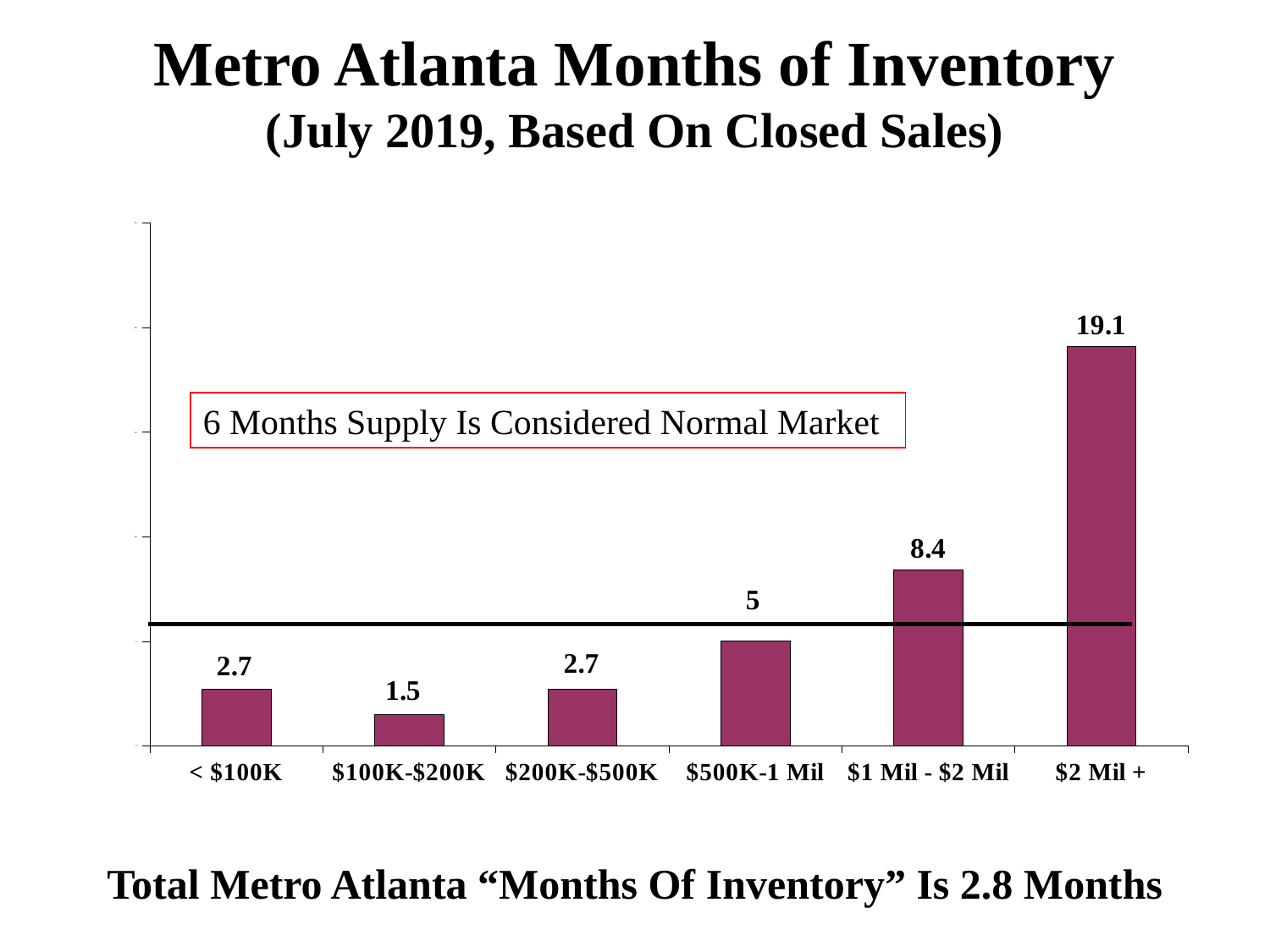
Which price range has the highest months of inventory? $2 Mil + According to the text box on the chart, how many months of supply is considered a normal market? 6 months What is the months of inventory value for the $500K-1 Mil price range? 5 What is the months of inventory value for the $2 Mil + price range? 19.1 Which price range has the lowest months of inventory? $100K-$200K What kind of chart is shown on the slide? Bar chart How many price range categories are shown on the chart? 6 What is the months of inventory value for the $1 Mil - $2 Mil price range? 8.4 What is the months of inventory value for the $100K-$200K price range? 1.5 Which has a larger months of inventory value, $500K-1 Mil or $200K-$500K? $500K-1 Mil What is the difference in months of inventory between the < $100K and $100K-$200K price ranges? 1.2 What is the difference in months of inventory between the $2 Mil + and $1 Mil - $2 Mil price ranges? 10.7